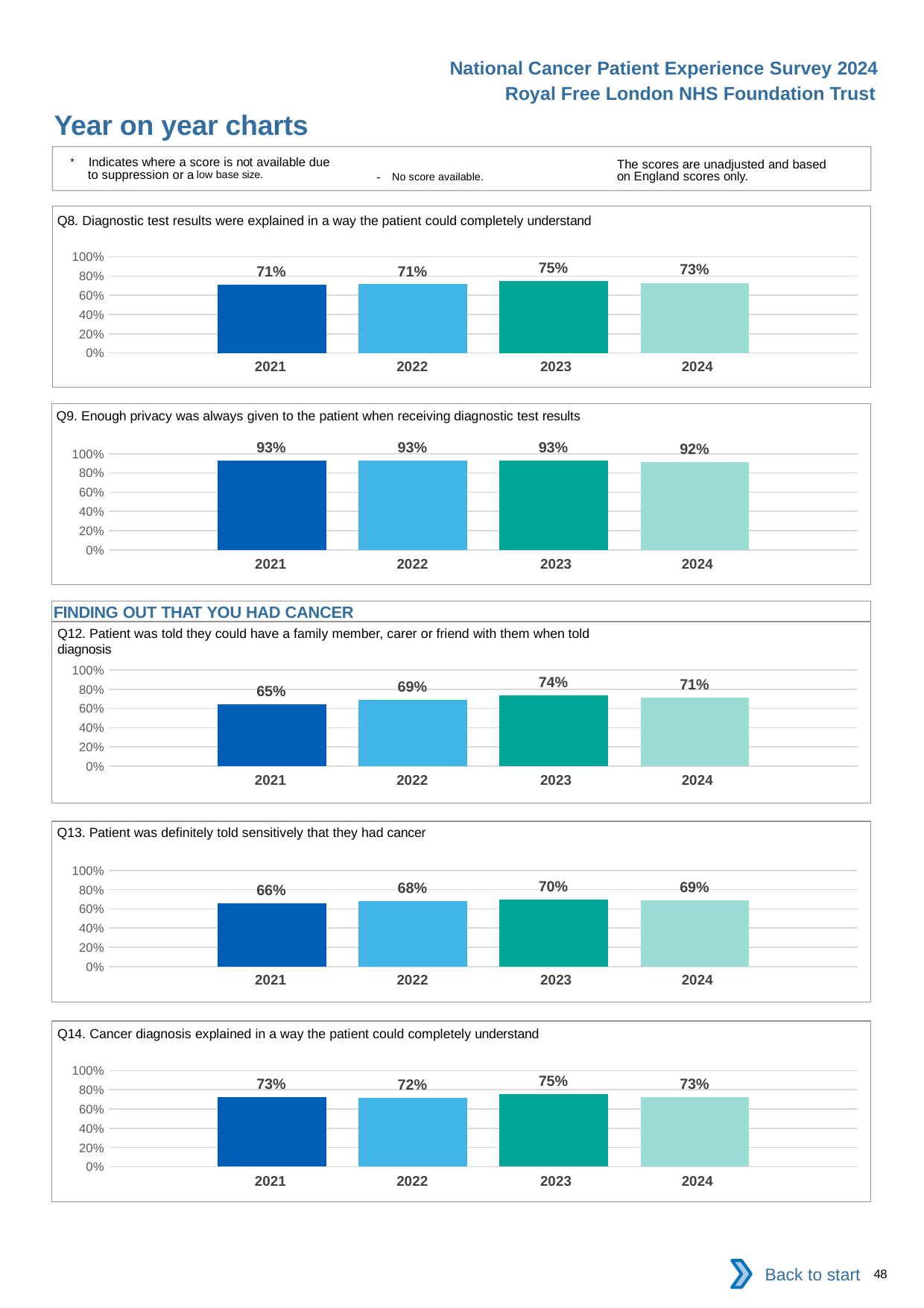
In the Q13 chart (Patient was definitely told sensitively that they had cancer), what is the value for 2022? 68% In the Q13 chart, is the value for 2021 larger or smaller than the value for 2023? smaller In the Q8 chart (Diagnostic test results were explained in a way the patient could completely understand), what is the value for 2023? 75% In the Q12 chart, which year has the lowest value? 2021 How many years are shown on the x axis of the Q8 chart? 4 In the Q9 chart, which year has the lowest value? 2024 In the Q14 chart (Cancer diagnosis explained in a way the patient could completely understand), what is the value for 2022? 72% In the Q8 chart, which year has the highest value? 2023 In the Q14 chart, what is the difference between the 2023 and 2024 values? 2% In the Q12 chart (Patient was told they could have a family member, carer or friend with them when told diagnosis), what is the difference between the 2023 and 2021 values? 9% In the Q9 chart (Enough privacy was always given to the patient when receiving diagnostic test results), what is the value for 2024? 92% What type of chart is the Q9 chart? Bar chart